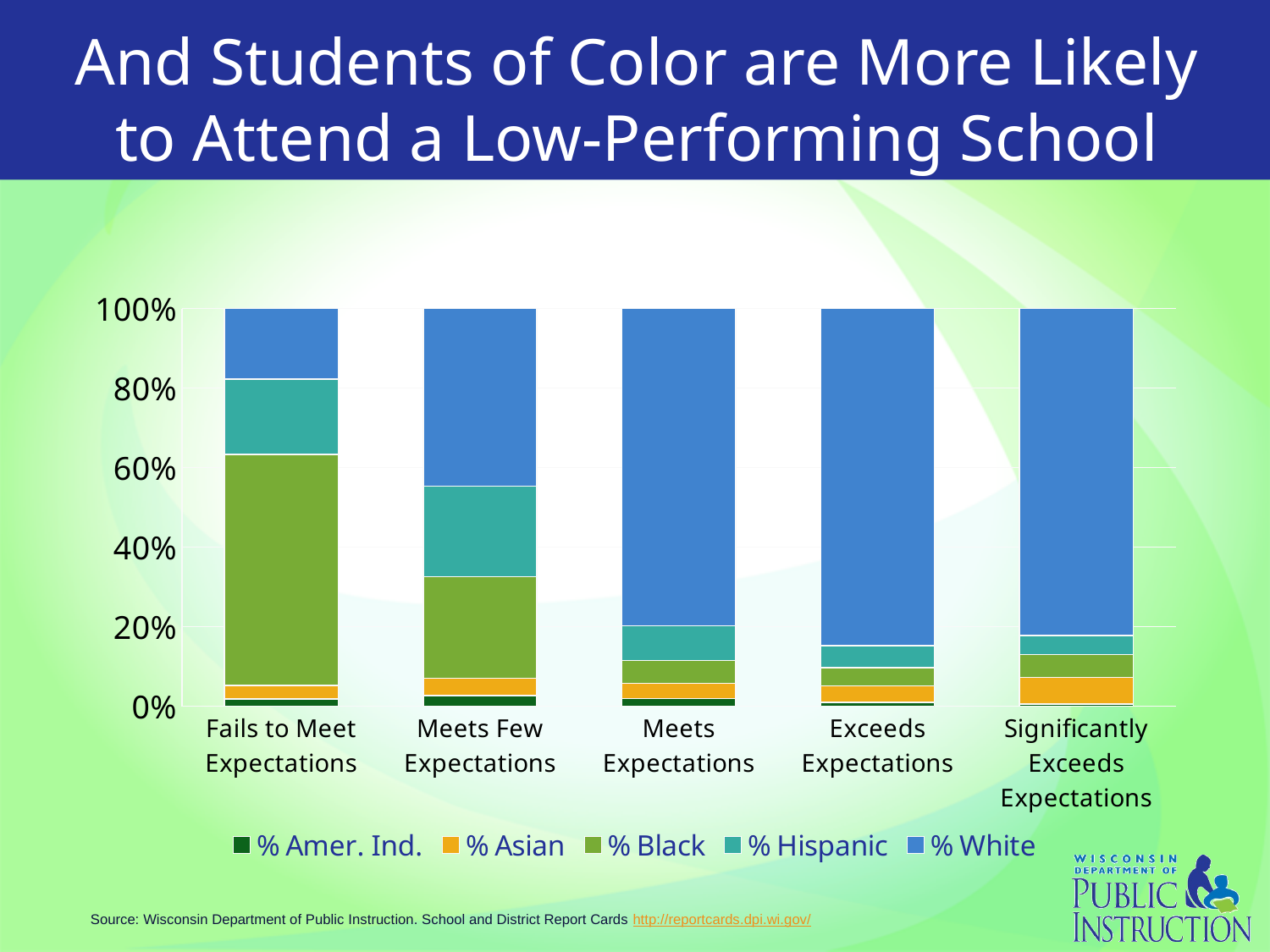
In the Fails to Meet Expectations bar, which is larger: the % Black segment or the % White segment? % Black What is the title of the slide containing the chart? And Students of Color are More Likely to Attend a Low-Performing School Which category has the smallest % White segment? Fails to Meet Expectations Which series is shown in orange in the legend? % Asian What kind of chart is shown on the slide? Stacked bar chart Moving from Fails to Meet Expectations to Exceeds Expectations, does the % White share rise or fall? rise How many school rating categories are shown on the x axis? 5 Is the % White share for Meets Expectations greater or less than 60%? greater Which category has the largest % Black segment? Fails to Meet Expectations Is the % White share for Fails to Meet Expectations greater or less than 40%? less How many series does the legend list? 5 Is the % Black share for Fails to Meet Expectations greater or less than 40%? greater